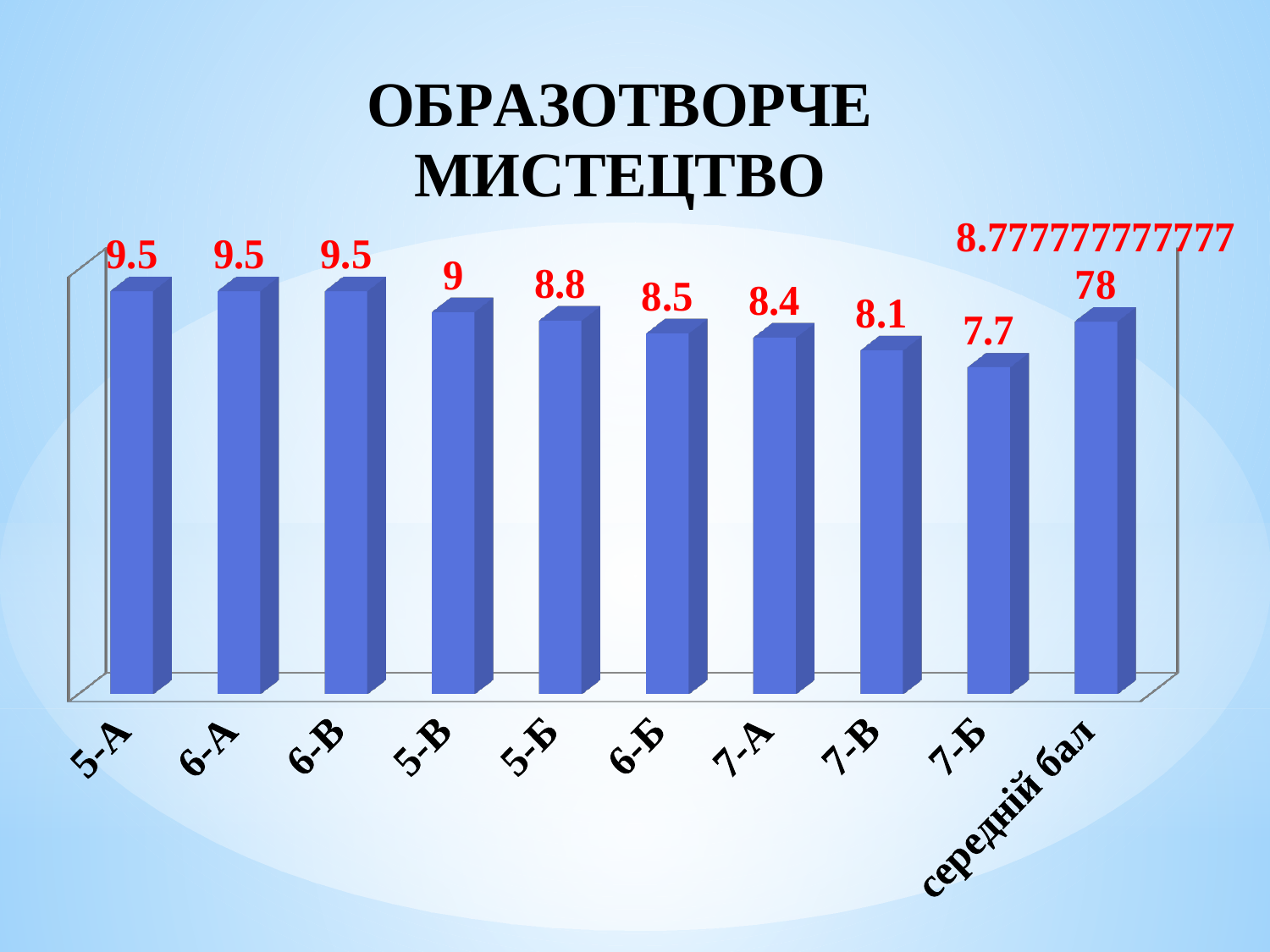
How many bars are shown in the chart? 10 What is the value for 5-Б? 8.8 What is the value for 7-А? 8.4 What is the value for 7-Б? 7.7 What is the value for 6-Б? 8.5 Which category has the lowest value? 7-Б Which is larger, the value for 5-Б or the value for 7-В? 5-Б What is the title of the chart? ОБРАЗОТВОРЧЕ МИСТЕЦТВО What is the difference between the values for 5-В and 7-В? 0.9 What kind of chart is shown on the slide? Bar chart What is the value for 5-В? 9 What is the difference between the values for 5-А and 7-Б? 1.8